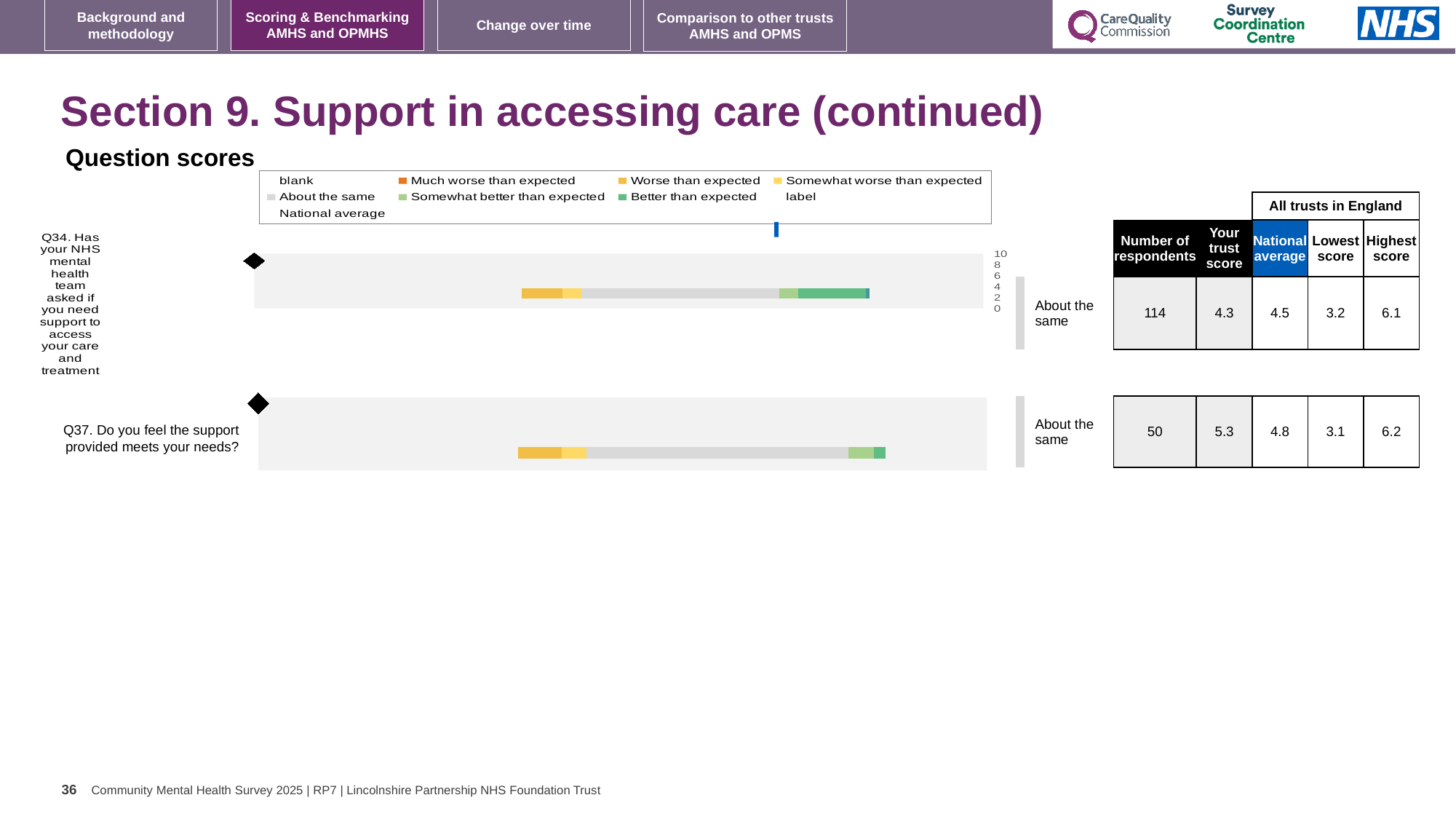
How many respondents answered Q34? 114 Which benchmark category is Q34 placed in? About the same Which question has the higher trust score, Q34 or Q37? Q37 What is the trust score for Q34 (Has your NHS mental health team asked if you need support to access your care and treatment)? 4.3 By how much does the trust score for Q37 exceed the national average for Q37? 0.5 What is the trust score for Q37 (Do you feel the support provided meets your needs)? 5.3 For Q34, which is larger: the trust score or the national average? national average What is the difference between the highest score and the lowest score for Q34 across all trusts in England? 2.9 How many questions are plotted in the question scores chart? 2 What is the national average score for Q37? 4.8 What kind of chart is used to show the question scores for Q34 and Q37? bar chart What is the highest score for Q37 across all trusts in England? 6.2